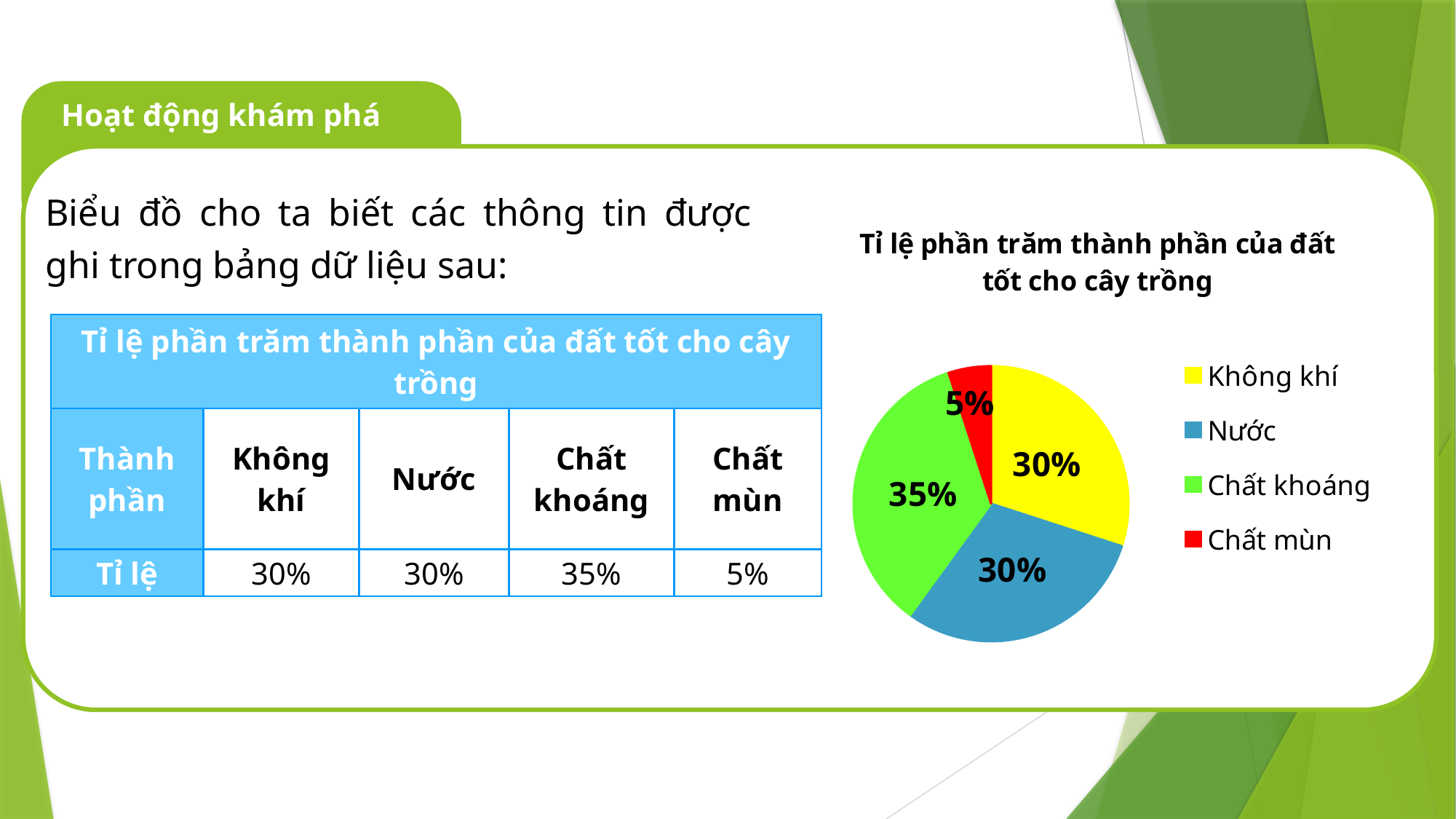
What is the value for Chất mùn in the pie chart? 5% What is the title of the pie chart? Tỉ lệ phần trăm thành phần của đất tốt cho cây trồng What is the difference between the values for Chất khoáng and Chất mùn? 30% What colour is the slice for Chất mùn in the pie chart? Red What is the value for Không khí in the pie chart? 30% How many categories does the pie chart show? 4 What is the value for Chất khoáng in the pie chart? 35% Which category has the smallest slice in the pie chart? Chất mùn Which is larger, the slice for Chất khoáng or the slice for Nước? Chất khoáng Which category has the largest slice in the pie chart? Chất khoáng What kind of chart is shown on the slide? Pie chart What is the value for Nước in the pie chart? 30%